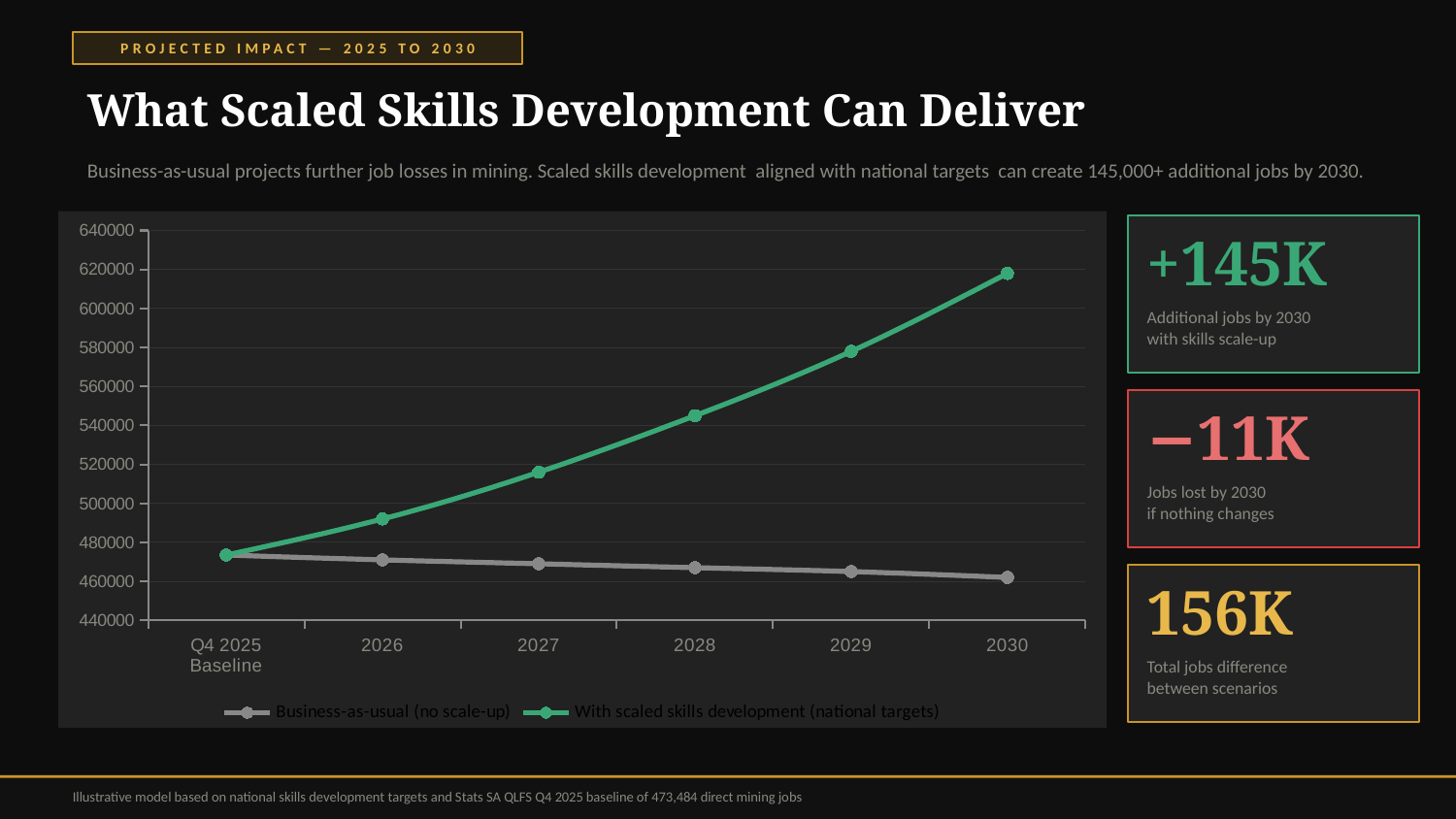
In 2030, which series has the larger value: 'Business-as-usual (no scale-up)' or 'With scaled skills development (national targets)'? With scaled skills development (national targets) What kind of chart is shown on the slide? line chart In which year does the 'With scaled skills development (national targets)' series reach its highest value? 2030 In which year does the 'Business-as-usual (no scale-up)' series reach its lowest value? 2030 Is the 2030 value for 'Business-as-usual (no scale-up)' greater or less than 480000? less Does the 'Business-as-usual (no scale-up)' series rise or fall from Q4 2025 Baseline to 2030? fall What colour is the line for 'With scaled skills development (national targets)'? green How many series does the chart legend list? 2 Is the 2028 value for 'With scaled skills development (national targets)' greater or less than 520000? greater How many points are plotted along the x axis for each series? 6 Does the 'With scaled skills development (national targets)' series rise or fall from Q4 2025 Baseline to 2030? rise Is the 2030 value for 'With scaled skills development (national targets)' greater or less than 600000? greater